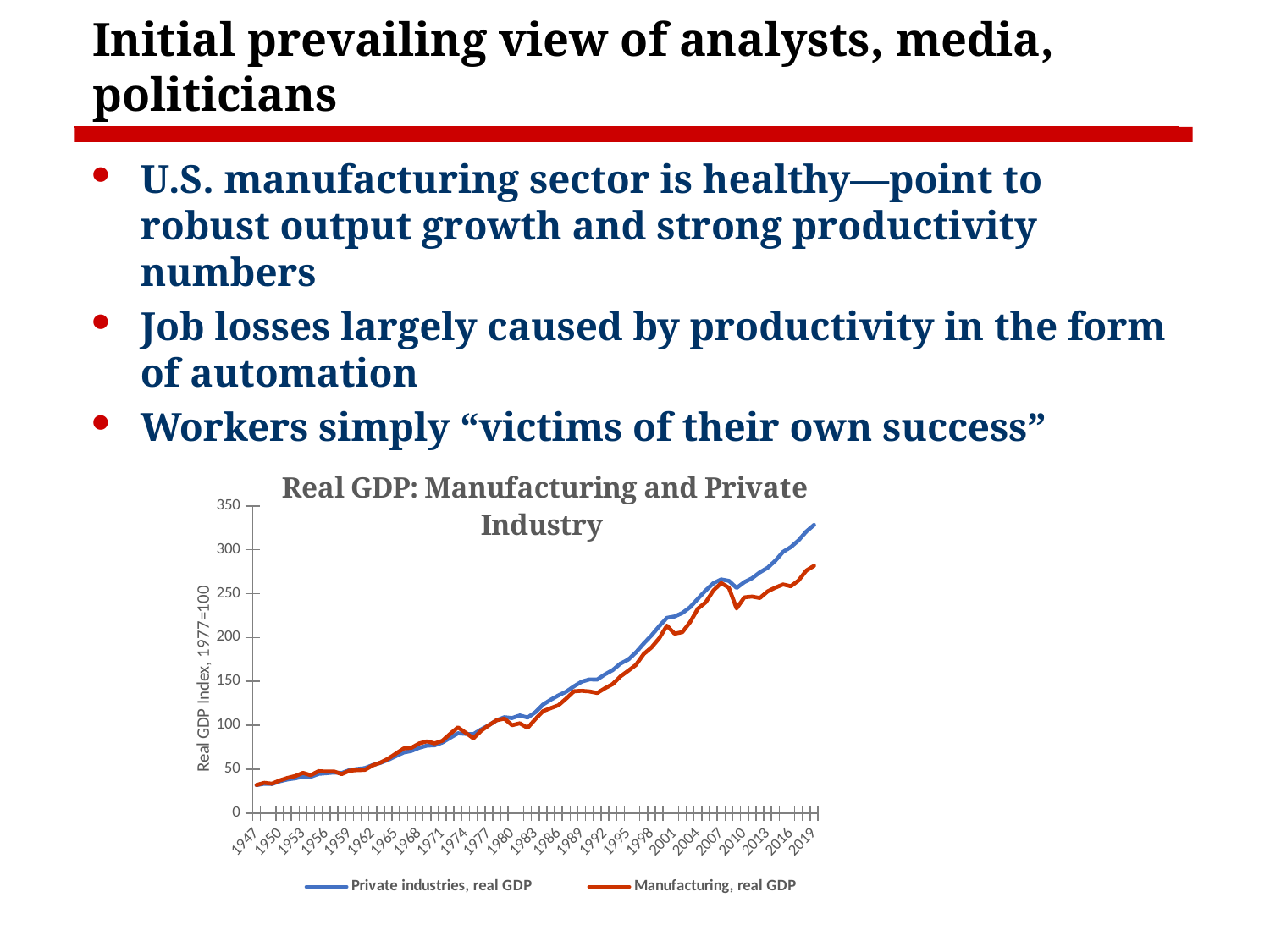
What is the title of the chart? Real GDP: Manufacturing and Private Industry In which year does Private industries, real GDP reach its highest value? 2019 Is the value for Private industries, real GDP in 2007 greater or less than 200? greater Is the value for Manufacturing, real GDP in 2019 greater or less than 300? less In which year is Manufacturing, real GDP at its lowest value? 1947 Is the value for Private industries, real GDP in 2019 greater or less than 300? greater How many series does the legend of the chart list? 2 What is the label on the vertical axis of the chart? Real GDP Index, 1977=100 What kind of chart is shown on the slide? line chart Do the values for Private industries, real GDP rise or fall from 1947 to 2019? rise In 2019, which series has the higher value: Private industries, real GDP or Manufacturing, real GDP? Private industries, real GDP